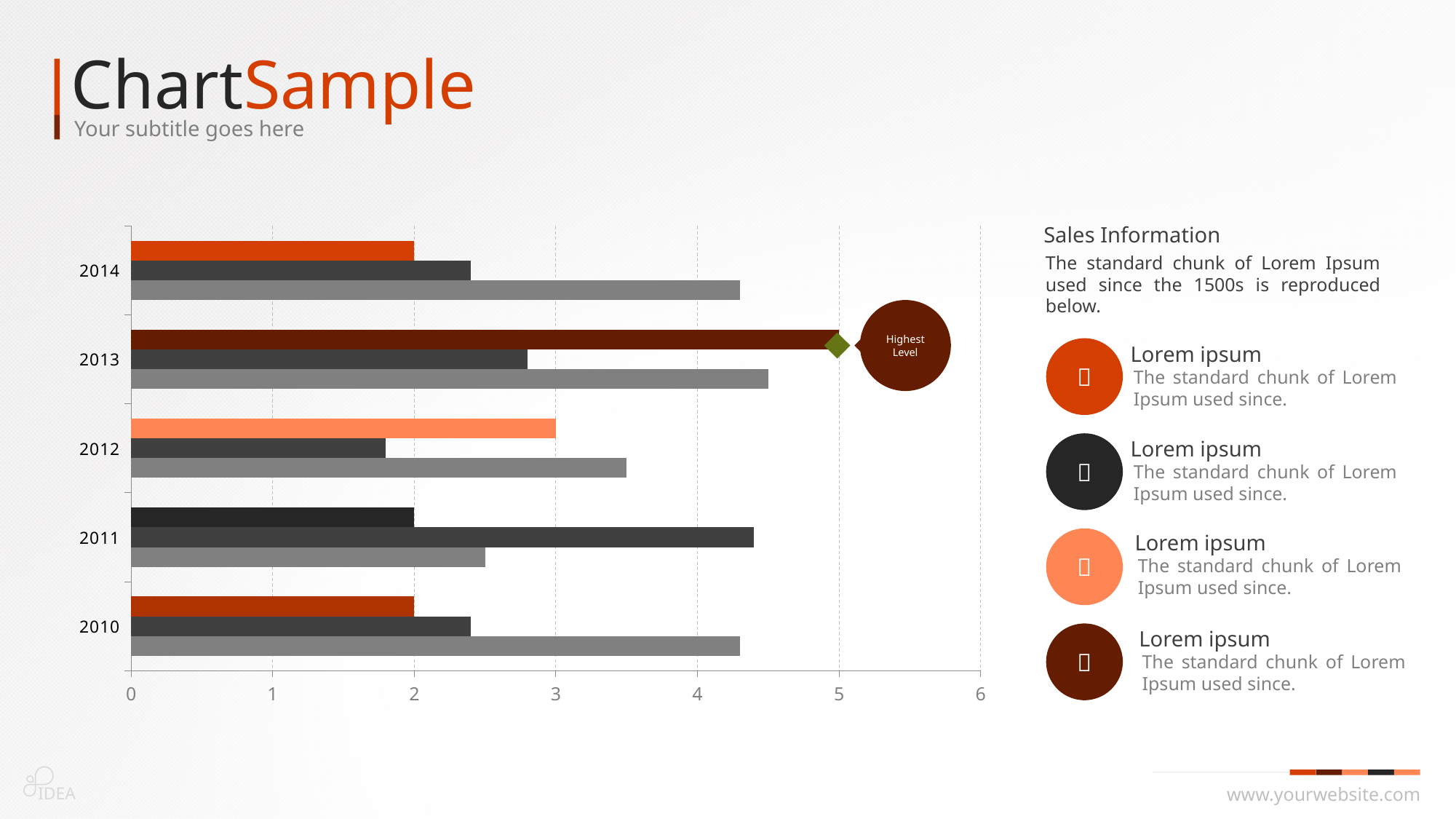
What value does the top (orange) bar for 2014 reach? 2 What is the difference between the top bar for 2013 and the top bar for 2014? 3 Which year has the longest bar in the chart? 2013 What value does the top (dark red) bar for 2013 reach? 5 Which year's bar is annotated with the label "Highest Level"? 2013 What value does the top (light orange) bar for 2012 reach? 3 How many years are shown on the vertical axis of the chart? 5 What kind of chart is shown on the slide? bar chart How many bars are plotted for each year in the chart? 3 Is the value of the light gray bar for 2013 greater or less than 4? greater Which is larger, the top bar for 2012 or the top bar for 2011? 2012 Is the value of the dark gray bar for 2012 greater or less than 2? less